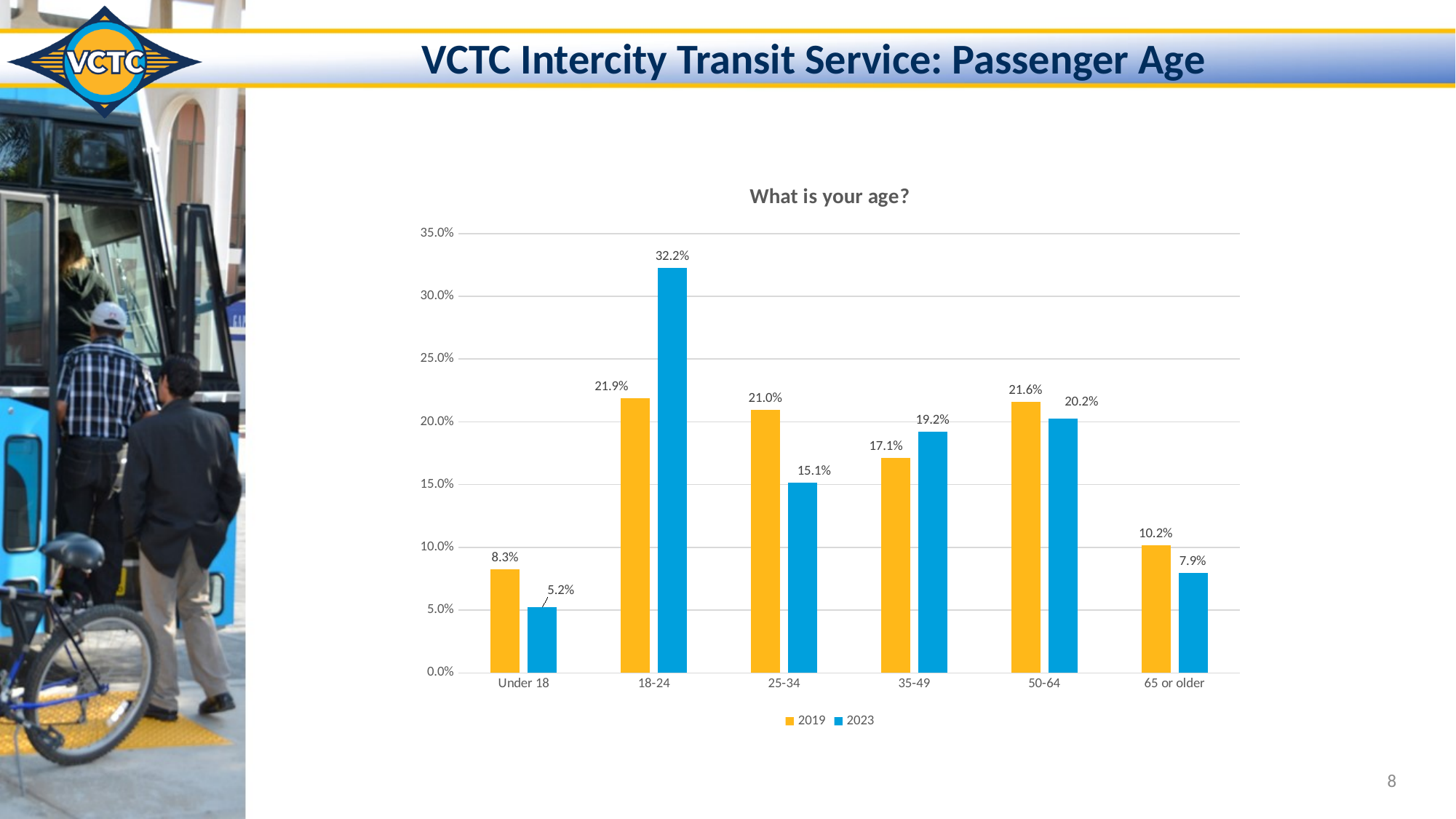
What kind of chart is shown on the slide? Bar chart What is the 2019 value for the 65 or older age group? 10.2% How many series does the legend list? 2 For the 35-49 age group, which year has the larger value, 2019 or 2023? 2023 What is the 2023 value for the 18-24 age group? 32.2% What is the difference between the 2023 and 2019 values for the 18-24 age group? 10.3% Is the 2023 value for the 50-64 age group greater or less than 15.0%? greater Which age group has the lowest 2019 value? Under 18 What is the 2023 value for the Under 18 age group? 5.2% Which age group has the highest 2023 value? 18-24 What is the difference between the 2019 and 2023 values for the 25-34 age group? 5.9% How many age groups are shown on the x axis? 6